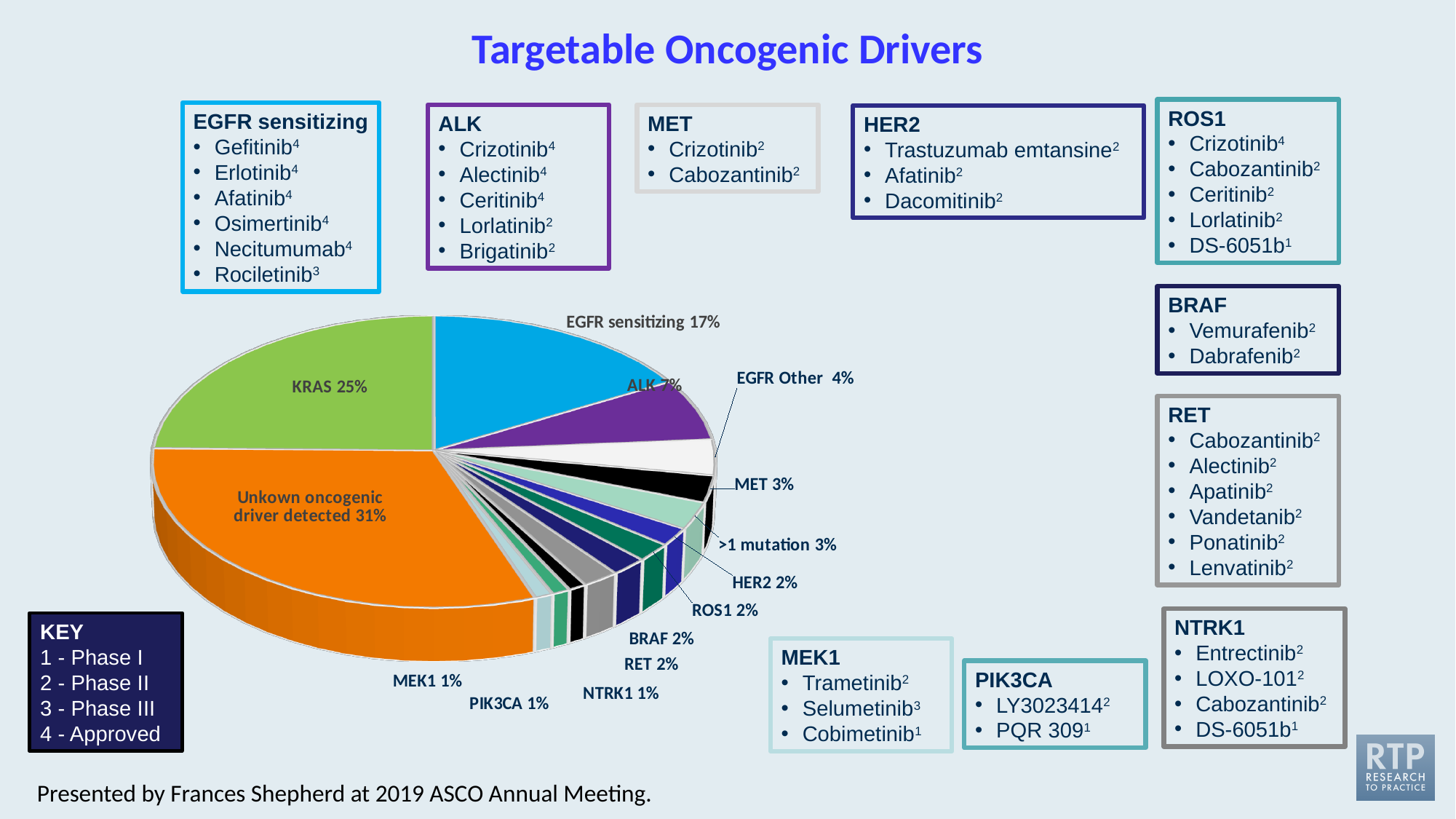
Which slice of the pie chart is the largest? Unkown oncogenic driver detected What share of the pie is EGFR sensitizing? 17% What is the difference in percentage points between EGFR sensitizing and EGFR Other? 13 What percentage is shown for ALK in the pie chart? 7% What percentage of the pie is labelled KRAS? 25% What percentage is shown for 'Unkown oncogenic driver detected'? 31% How many slices are labelled in the pie chart? 14 Which is larger in the pie chart, KRAS or EGFR sensitizing? KRAS What kind of chart is shown on the slide? pie chart What is the difference in percentage points between KRAS and ALK? 18 What percentage is shown for MET in the pie chart? 3% What percentage is shown for NTRK1 in the pie chart? 1%